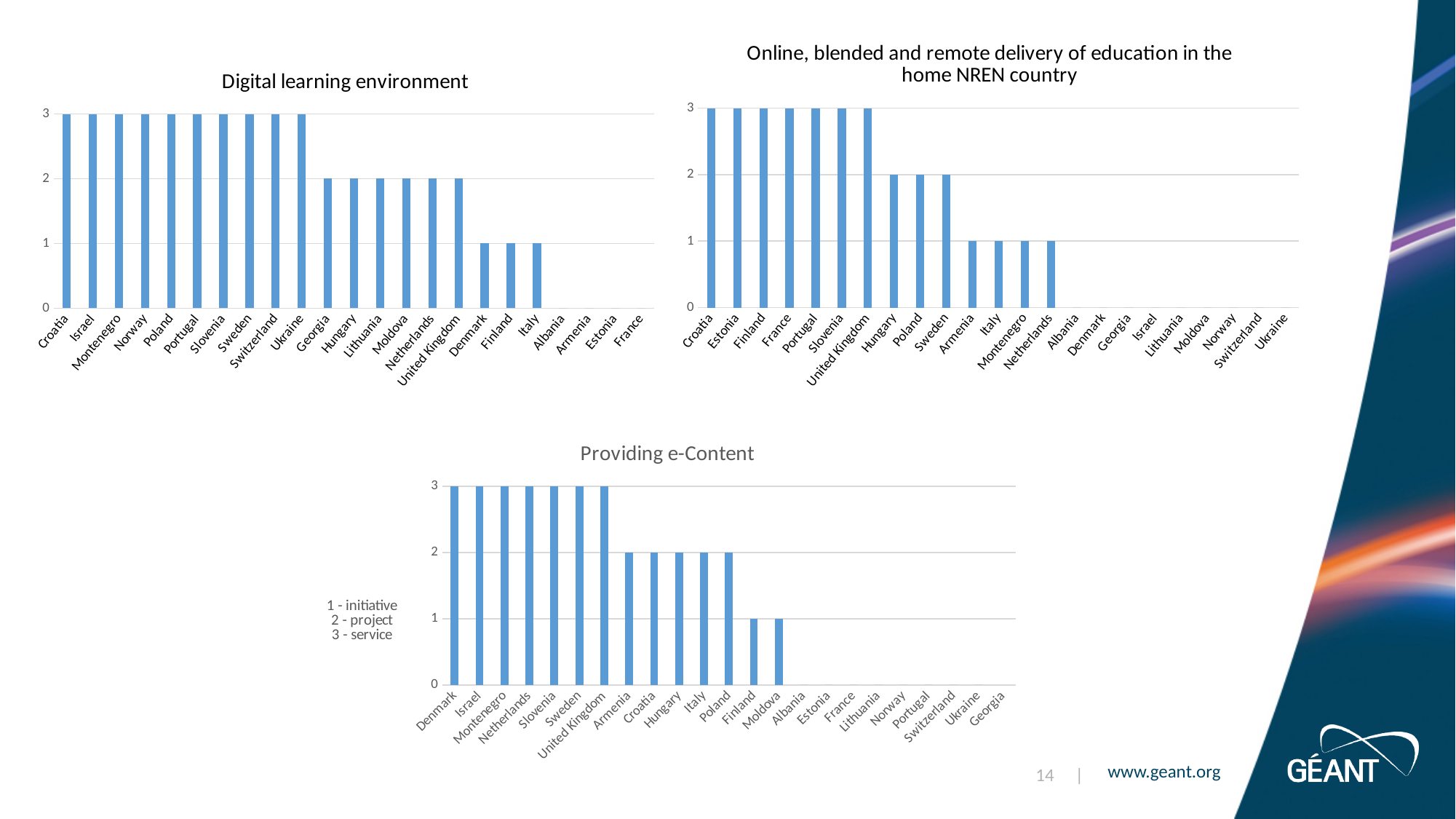
In the 'Online, blended and remote delivery of education in the home NREN country' chart, what is the difference between the values for Croatia and Hungary? 1 In the 'Digital learning environment' chart, what is the value for Finland? 1 In the 'Online, blended and remote delivery of education in the home NREN country' chart, what is the value for Netherlands? 1 According to the key on the slide, what does a value of 3 represent? service What type of chart is 'Providing e-Content'? Bar chart In the 'Digital learning environment' chart, how many countries have a value of 3? 10 In the 'Online, blended and remote delivery of education in the home NREN country' chart, what is the value for Sweden? 2 In the 'Providing e-Content' chart, how many countries have a value of 3? 7 In the 'Digital learning environment' chart, what is the value for Georgia? 2 In the 'Providing e-Content' chart, what is the value for Poland? 2 In the 'Providing e-Content' chart, what is the value for Moldova? 1 In the 'Digital learning environment' chart, which is larger, the value for Ukraine or the value for Italy? Ukraine